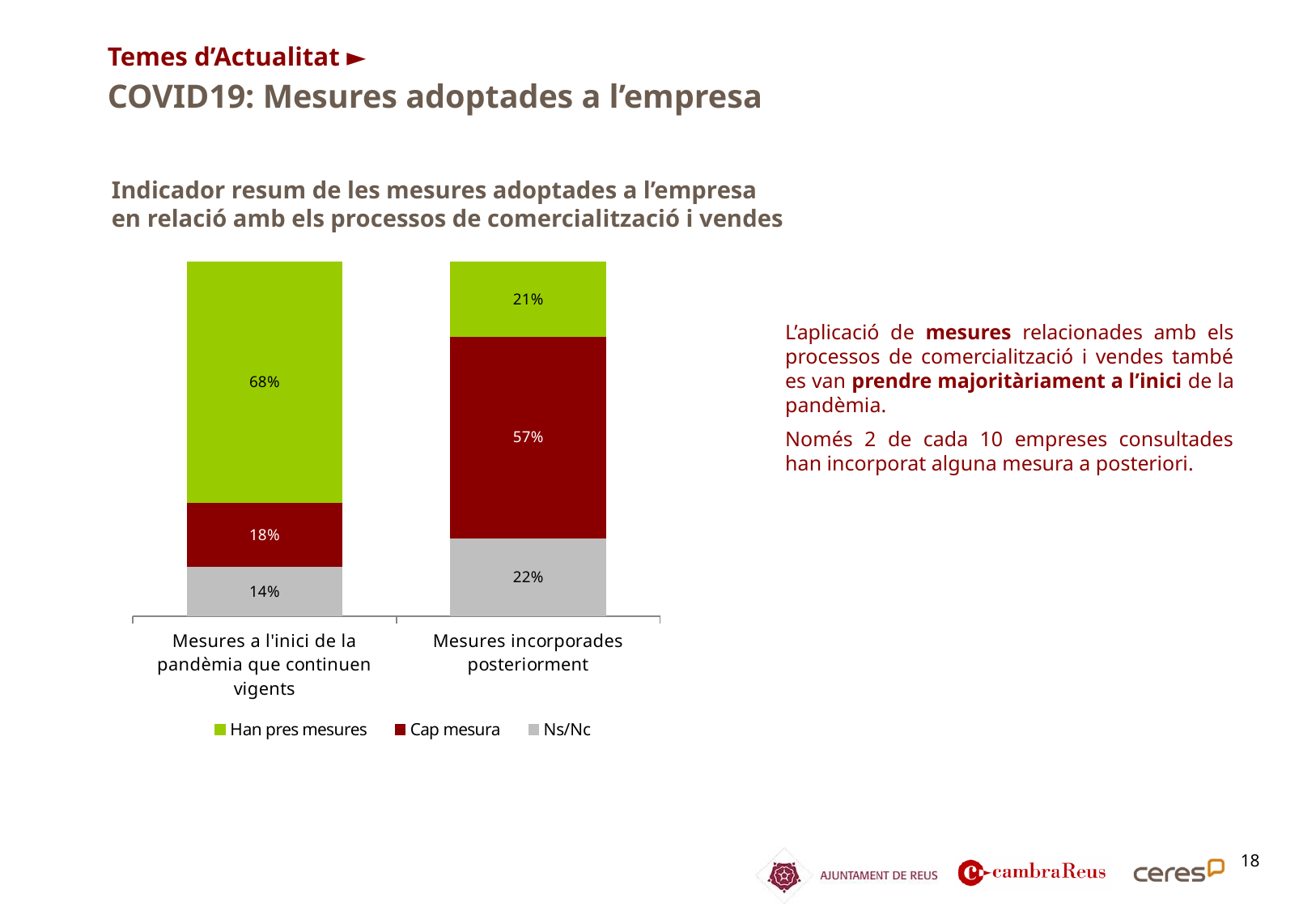
What kind of chart is shown on the slide? Stacked bar chart What is the value of 'Cap mesura' for 'Mesures incorporades posteriorment'? 57% How many series does the legend list? 3 Which category has the higher value for 'Han pres mesures'? Mesures a l'inici de la pandèmia que continuen vigents What is the value of 'Han pres mesures' for 'Mesures incorporades posteriorment'? 21% What is the value of 'Han pres mesures' for 'Mesures a l'inici de la pandèmia que continuen vigents'? 68% How many categories are shown on the x axis? 2 What is the difference between the 'Han pres mesures' values of the two categories? 47% What is the total of the stacked bar for 'Mesures incorporades posteriorment'? 100% Is the 'Ns/Nc' value larger for 'Mesures incorporades posteriorment' or for 'Mesures a l'inici de la pandèmia que continuen vigents'? Mesures incorporades posteriorment What is the value of 'Ns/Nc' for 'Mesures a l'inici de la pandèmia que continuen vigents'? 14% Which category has the lower value for 'Cap mesura'? Mesures a l'inici de la pandèmia que continuen vigents